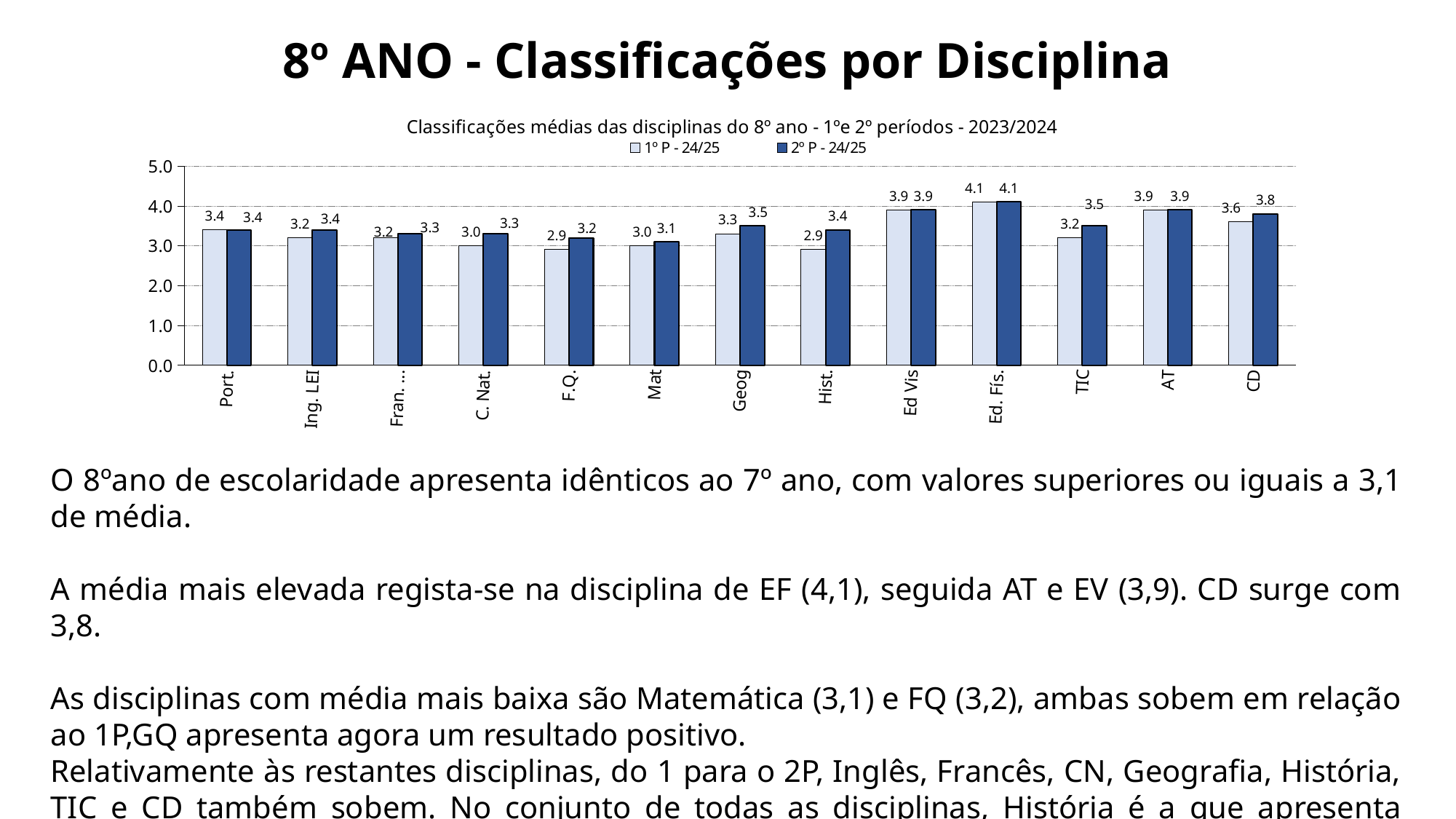
What kind of chart is shown on the slide? bar chart Which category has the highest value in the 2º P - 24/25 series? Ed. Fís. How many series does the legend list? 2 Which is larger for TIC: the 1º P - 24/25 value or the 2º P - 24/25 value? 2º P - 24/25 Is the value for Ed. Fís. in the 1º P - 24/25 series greater or less than 4.0? greater What is the difference between the 2º P - 24/25 and 1º P - 24/25 values for Hist.? 0.5 How many categories (disciplines) are shown on the x axis? 13 What is the value for CD in the 2º P - 24/25 series? 3.8 What is the title of the chart? Classificações médias das disciplinas do 8º ano - 1ºe 2º períodos - 2023/2024 What is the value for Hist. in the 2º P - 24/25 series? 3.4 What is the value for F.Q. in the 1º P - 24/25 series? 2.9 Which category has the lowest value in the 2º P - 24/25 series? Mat